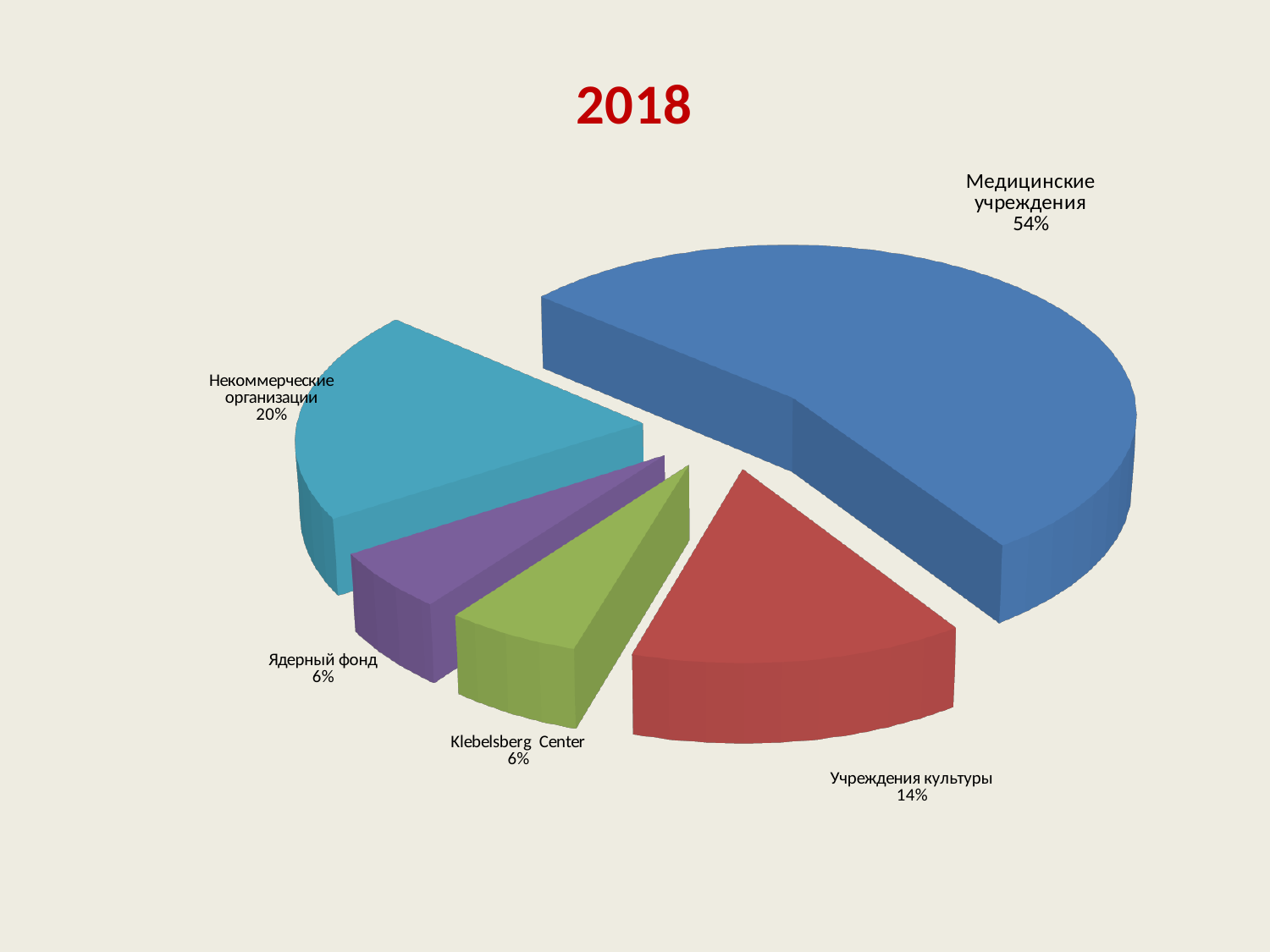
What share of the pie is Некоммерческие организации? 20% What share of the pie is Ядерный фонд? 6% Which category has the largest slice of the pie? Медицинские учреждения Which is larger, the share of Учреждения культуры or the share of Некоммерческие организации? Некоммерческие организации What is the title of the chart? 2018 What kind of chart is shown on the slide? pie chart What share of the pie is Klebelsberg Center? 6% What is the difference between the shares of Медицинские учреждения and Некоммерческие организации? 34% How many slices does the pie chart have? 5 What colour is the slice for Учреждения культуры? red